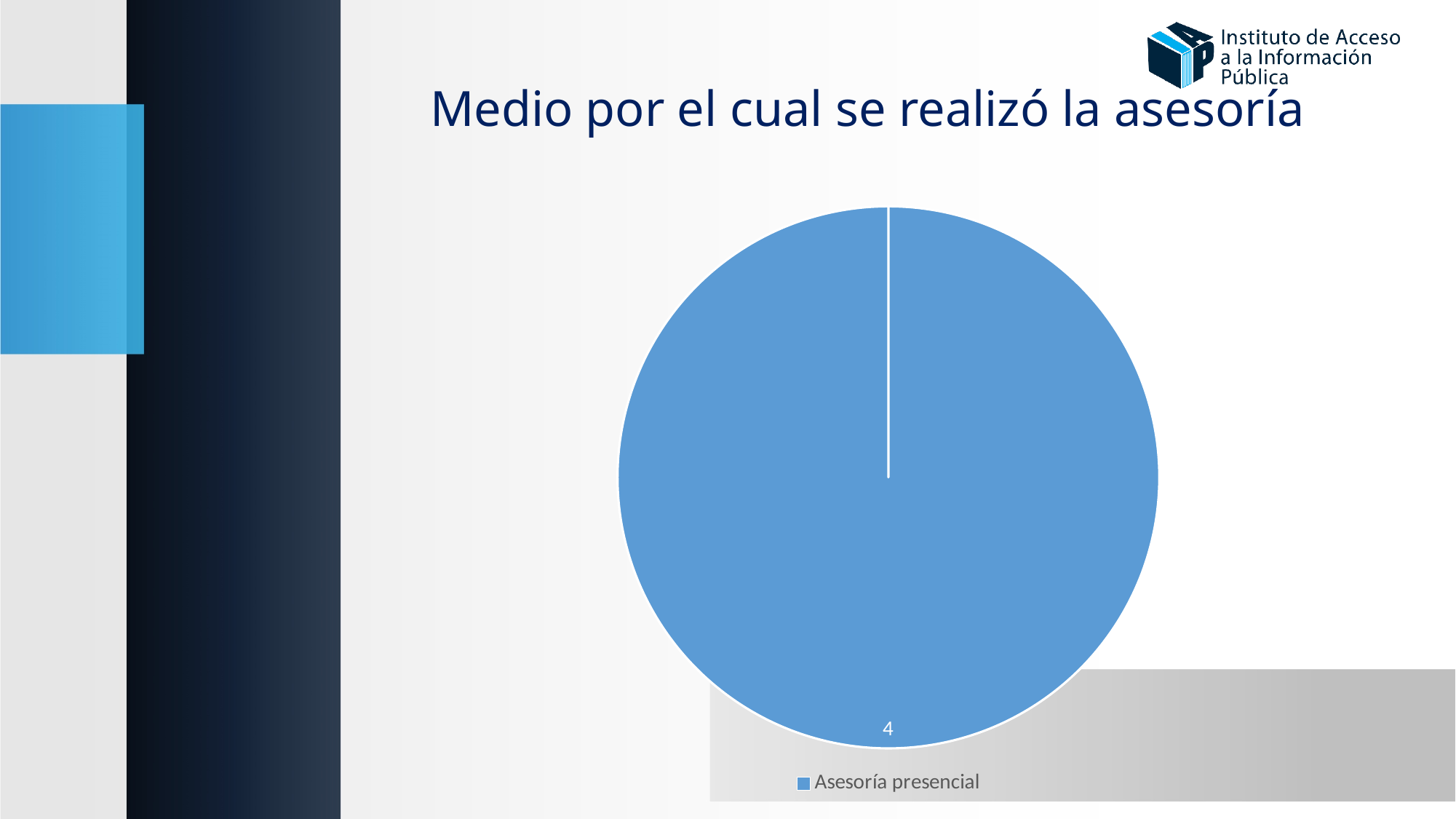
Is the value for Asesoría presencial greater or less than 10? less What is the total of all values plotted in the pie chart? 4 How many categories (slices) does the pie chart contain? 1 How many entries does the legend list? 1 What is the value shown for Asesoría presencial? 4 What share of the pie does the Asesoría presencial slice represent? 100% What kind of chart is shown on the slide? pie chart What is the name of the only category shown in the legend? Asesoría presencial Which category has the highest value in the chart? Asesoría presencial What is the title of the chart? Medio por el cual se realizó la asesoría